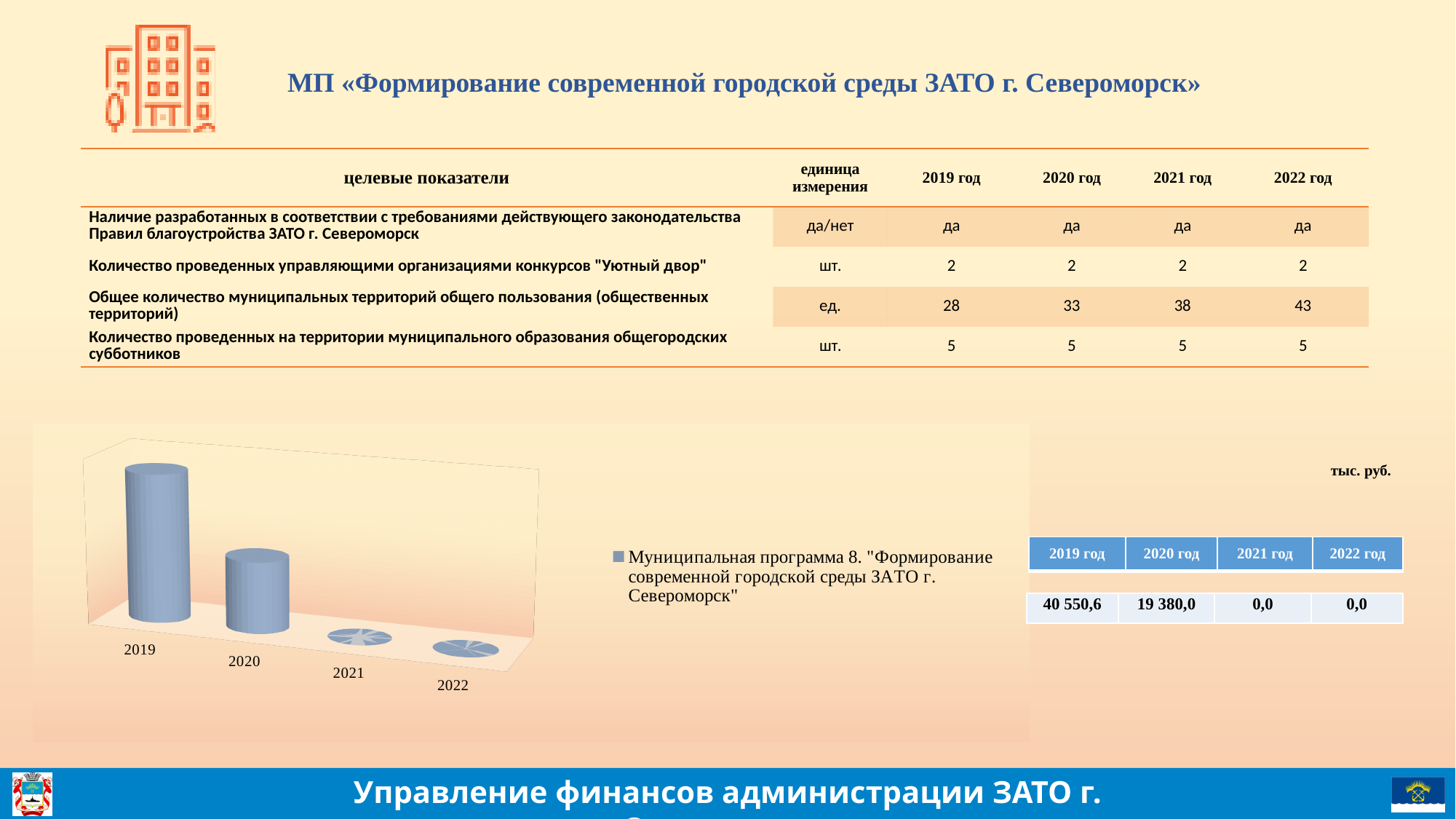
Which year has the tallest bar in the chart? 2019 According to the table next to the chart, what is the value for 2020 год? 19 380,0 According to the table next to the chart, what is the value for 2019 год? 40 550,6 How many series does the legend of the bar chart list? 1 What kind of chart is shown at the bottom left of the slide? bar chart What is the name of the series shown in the chart legend? Муниципальная программа 8. "Формирование современной городской среды ЗАТО г. Североморск" Is the bar for 2019 taller or shorter than the bar for 2020? taller How many years (categories) are plotted on the bar chart? 4 According to the table next to the chart, what is the value for 2021 год? 0,0 What unit of measurement is indicated above the table next to the chart? тыс. руб. Do the bar values rise or fall from 2019 to 2022? fall What is the difference between the 2019 and 2020 values shown in the table next to the chart? 21 170,6